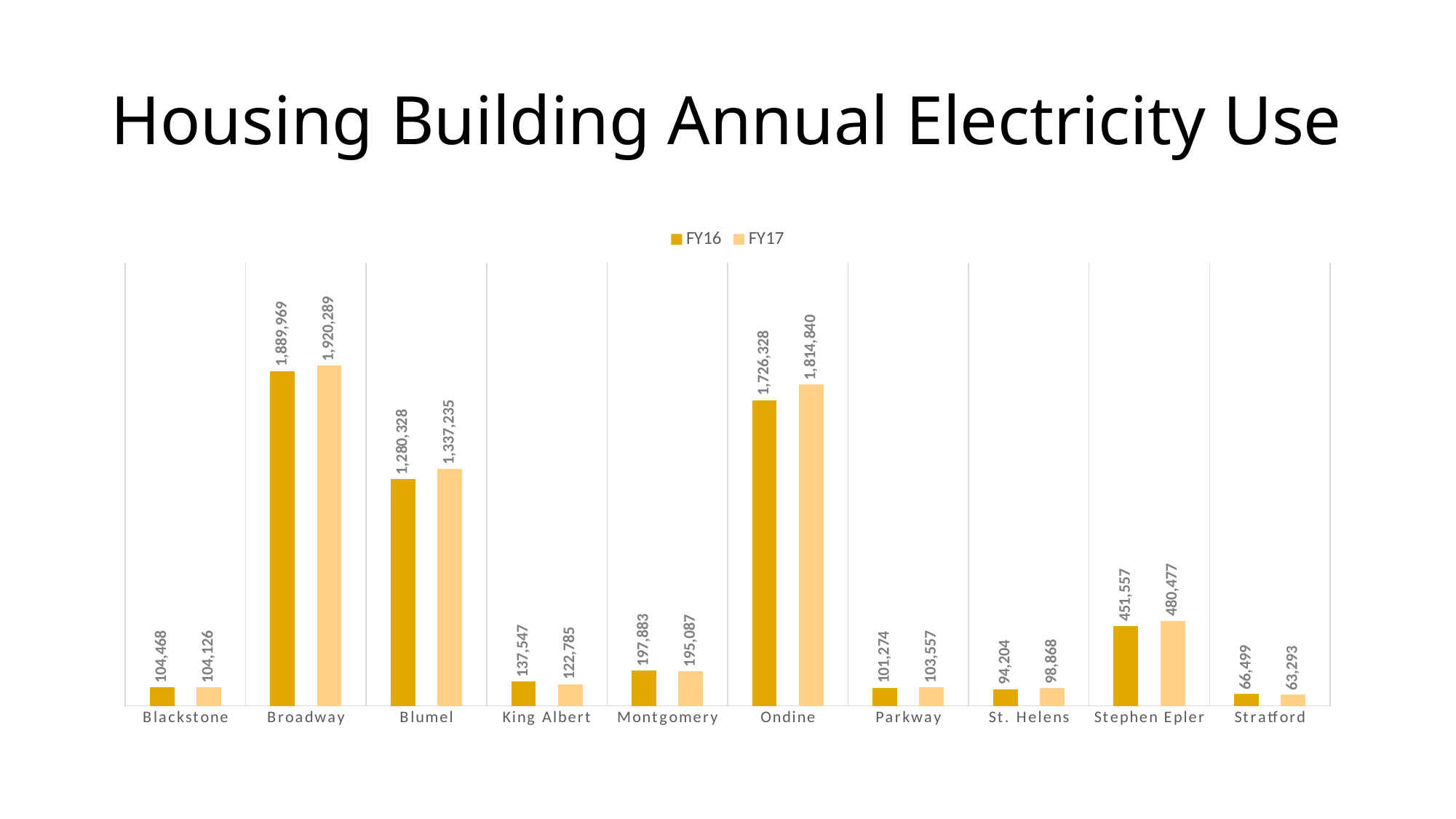
What is the FY17 value for King Albert? 122,785 What is the FY17 value for Stephen Epler? 480,477 What is the difference between the FY16 and FY17 values for King Albert? 14,762 Which is larger for Blumel, the FY16 value or the FY17 value? FY17 What kind of chart is shown on the slide? Bar chart How many buildings are shown on the x axis? 10 Which building has the highest FY17 value? Broadway What is the FY16 value for Ondine? 1,726,328 What is the title of the chart? Housing Building Annual Electricity Use How many series does the legend list? 2 Which building has the lowest FY16 value? Stratford What is the difference between the FY17 and FY16 values for Ondine? 88,512